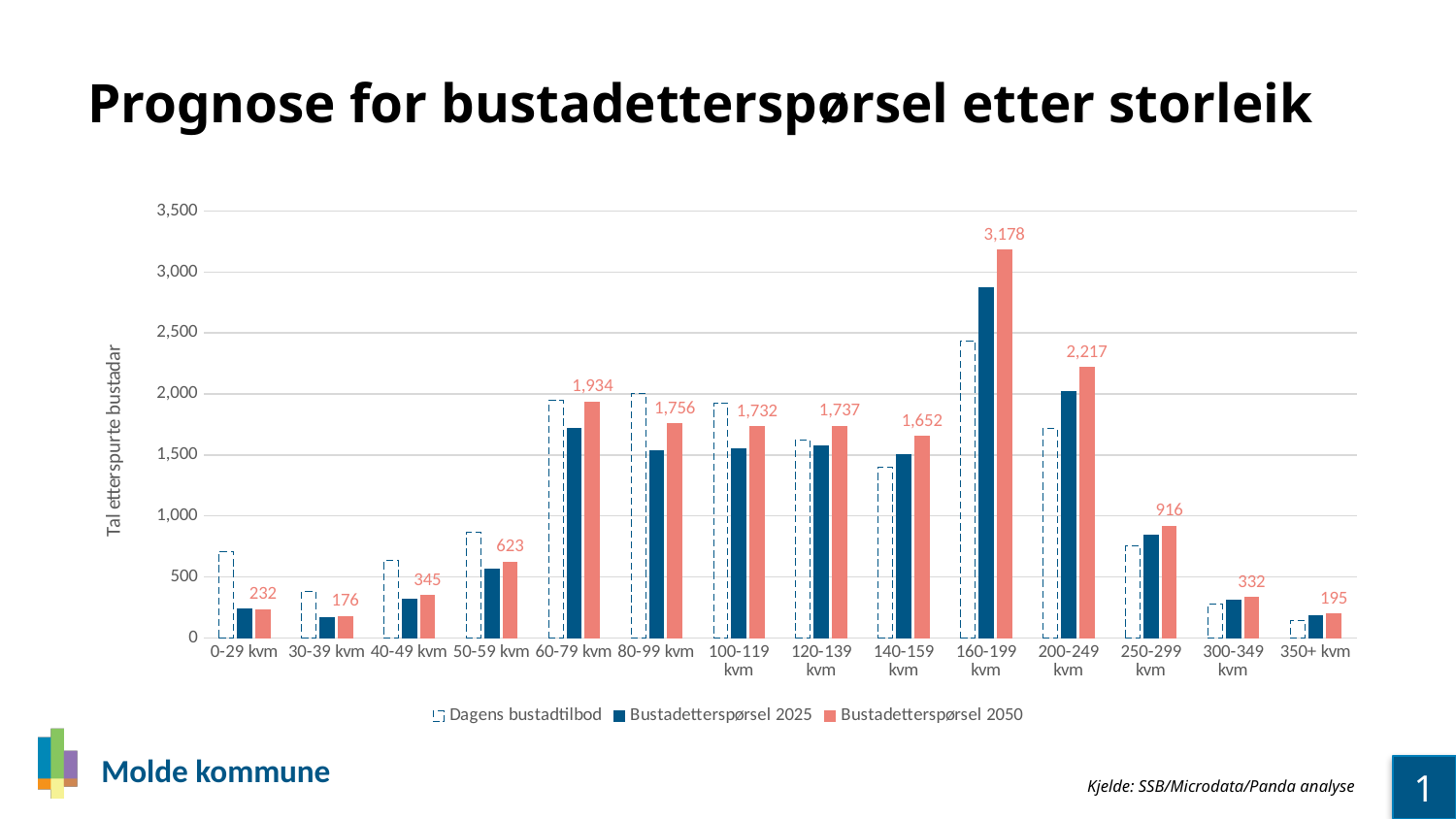
What is the Bustadetterspørsel 2050 value for the 50-59 kvm category? 623 What type of chart is shown on the slide? Bar chart Which category has the lowest Bustadetterspørsel 2050 value? 30-39 kvm What is the Bustadetterspørsel 2050 value for the 160-199 kvm category? 3,178 How many size categories are shown on the x axis? 14 Is the Dagens bustadtilbod value for 0-29 kvm greater or less than 1,000? less What is the Bustadetterspørsel 2050 value for the 300-349 kvm category? 332 How many series does the legend list? 3 Is the Bustadetterspørsel 2025 value for 160-199 kvm greater or less than 2,500? greater Which is larger, the Bustadetterspørsel 2050 value for 60-79 kvm or for 80-99 kvm? 60-79 kvm What is the difference between the Bustadetterspørsel 2050 values for 160-199 kvm and 200-249 kvm? 961 Which category has the highest Bustadetterspørsel 2050 value? 160-199 kvm